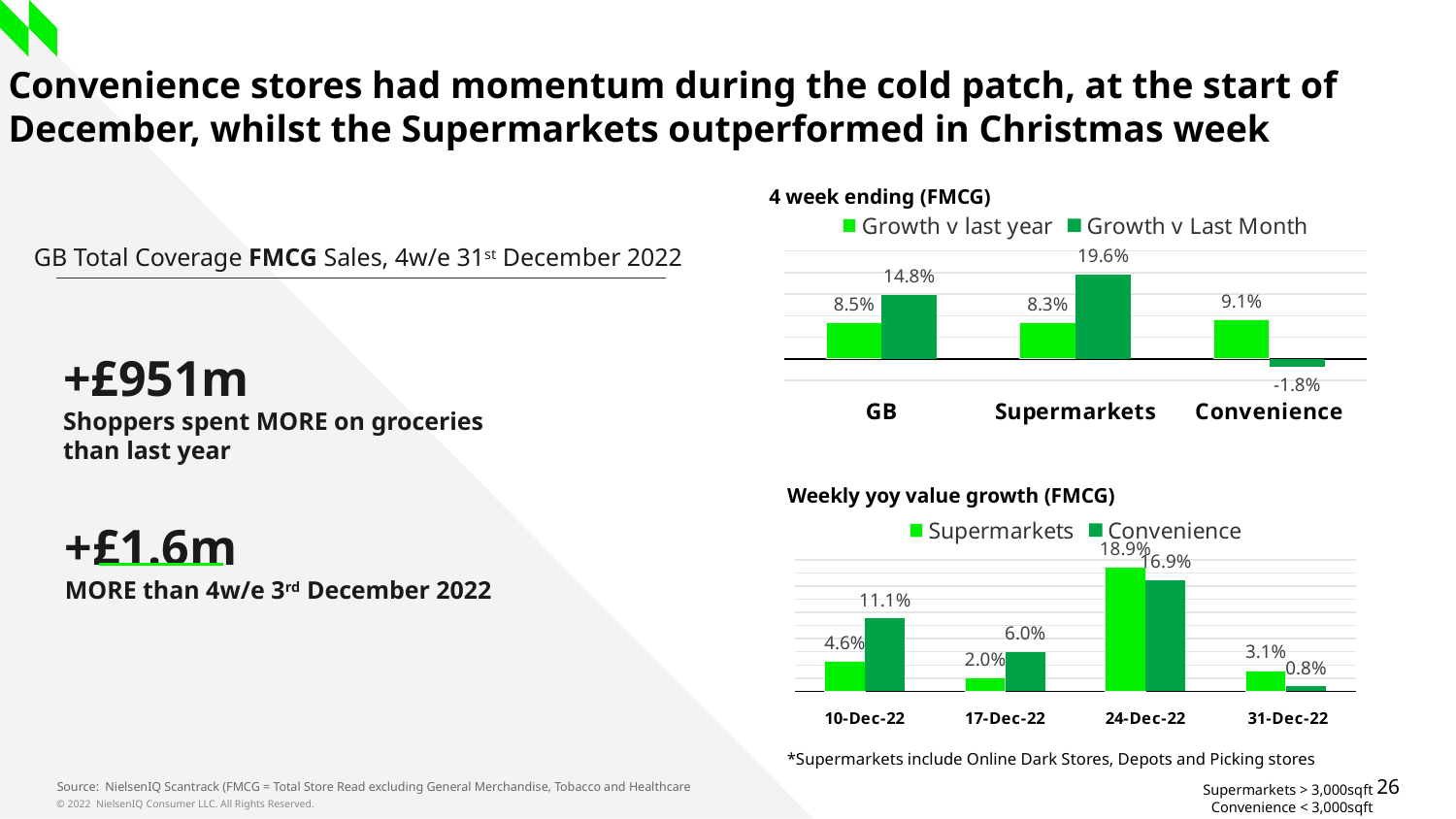
In the 'Weekly yoy value growth (FMCG)' chart, which week has the lowest Supermarkets value? 17-Dec-22 In the '4 week ending (FMCG)' chart, what is the Growth v Last Month value for Convenience? -1.8% In the '4 week ending (FMCG)' chart, what is the difference between the Growth v Last Month values for Supermarkets and GB? 4.8% In the '4 week ending (FMCG)' chart, what is the Growth v last year value for GB? 8.5% In the '4 week ending (FMCG)' chart, what is the Growth v Last Month value for Supermarkets? 19.6% How many series does the legend of the '4 week ending (FMCG)' chart list? 2 What type of chart is the 'Weekly yoy value growth (FMCG)' chart? Bar chart In the 'Weekly yoy value growth (FMCG)' chart, which is larger for 31-Dec-22: Supermarkets or Convenience? Supermarkets In the '4 week ending (FMCG)' chart, which category has the highest Growth v last year? Convenience In the 'Weekly yoy value growth (FMCG)' chart, what is the Convenience value for 10-Dec-22? 11.1% How many weeks are shown on the x axis of the 'Weekly yoy value growth (FMCG)' chart? 4 In the 'Weekly yoy value growth (FMCG)' chart, what is the Supermarkets value for 24-Dec-22? 18.9%